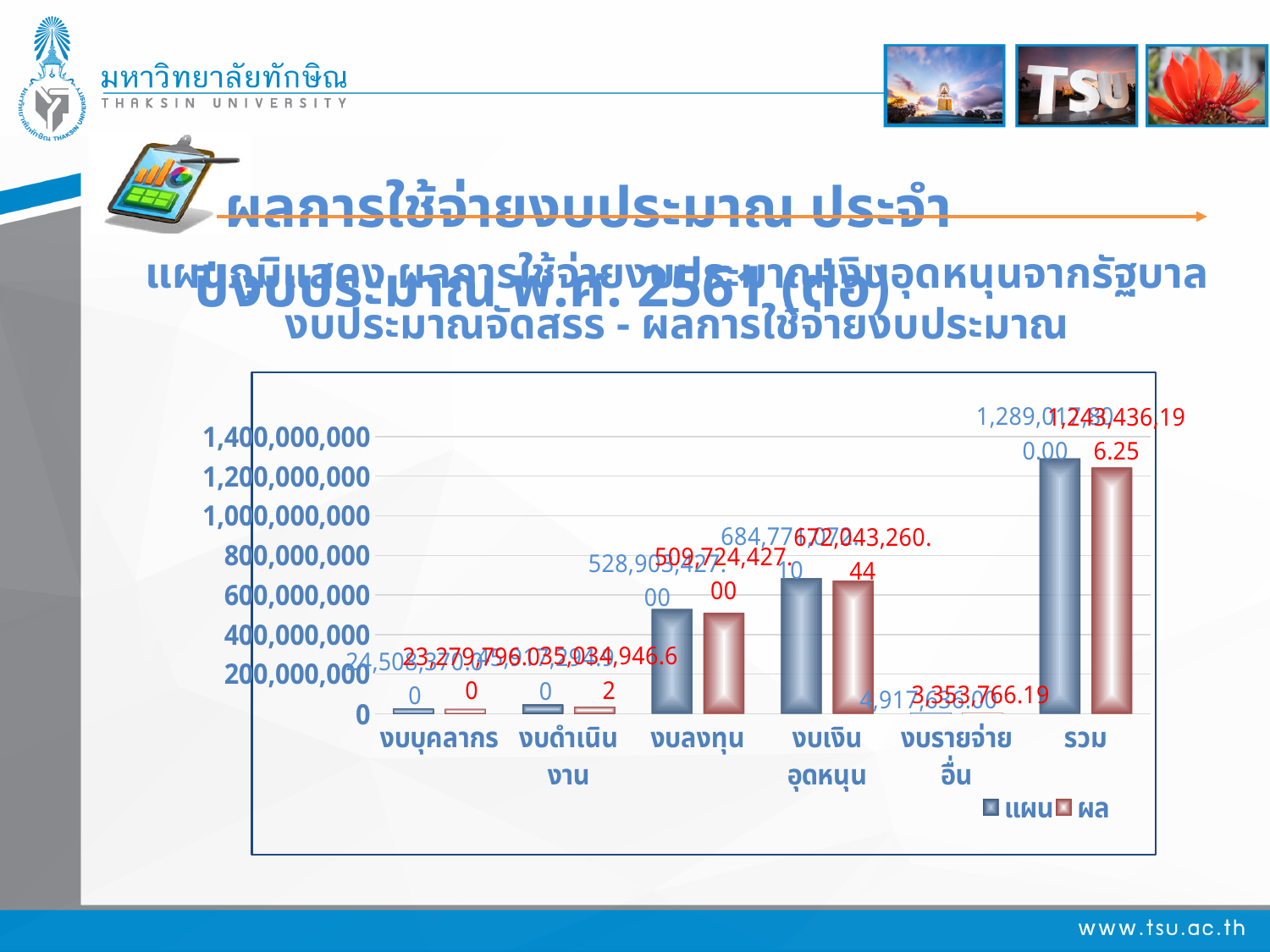
Is the แผน value for งบลงทุน greater or less than 400,000,000? greater Is the แผน value for รวม greater or less than 1,200,000,000? greater How many series does the legend list? 2 What are the two legend entries of the chart? แผน and ผล How many categories are shown on the x axis? 6 Which category has the lowest value for the ผล series? งบรายจ่ายอื่น For the แผน series, which is larger: งบเงินอุดหนุน or งบลงทุน? งบเงินอุดหนุน What is the ผล value for งบรายจ่ายอื่น? 3,353,766.19 Which category has the highest value for the แผน series? รวม What is the ผล value for งบลงทุน? 509,724,427.00 What is the ผล value for งบเงินอุดหนุน? 672,043,260.44 What kind of chart is shown on the slide? bar chart